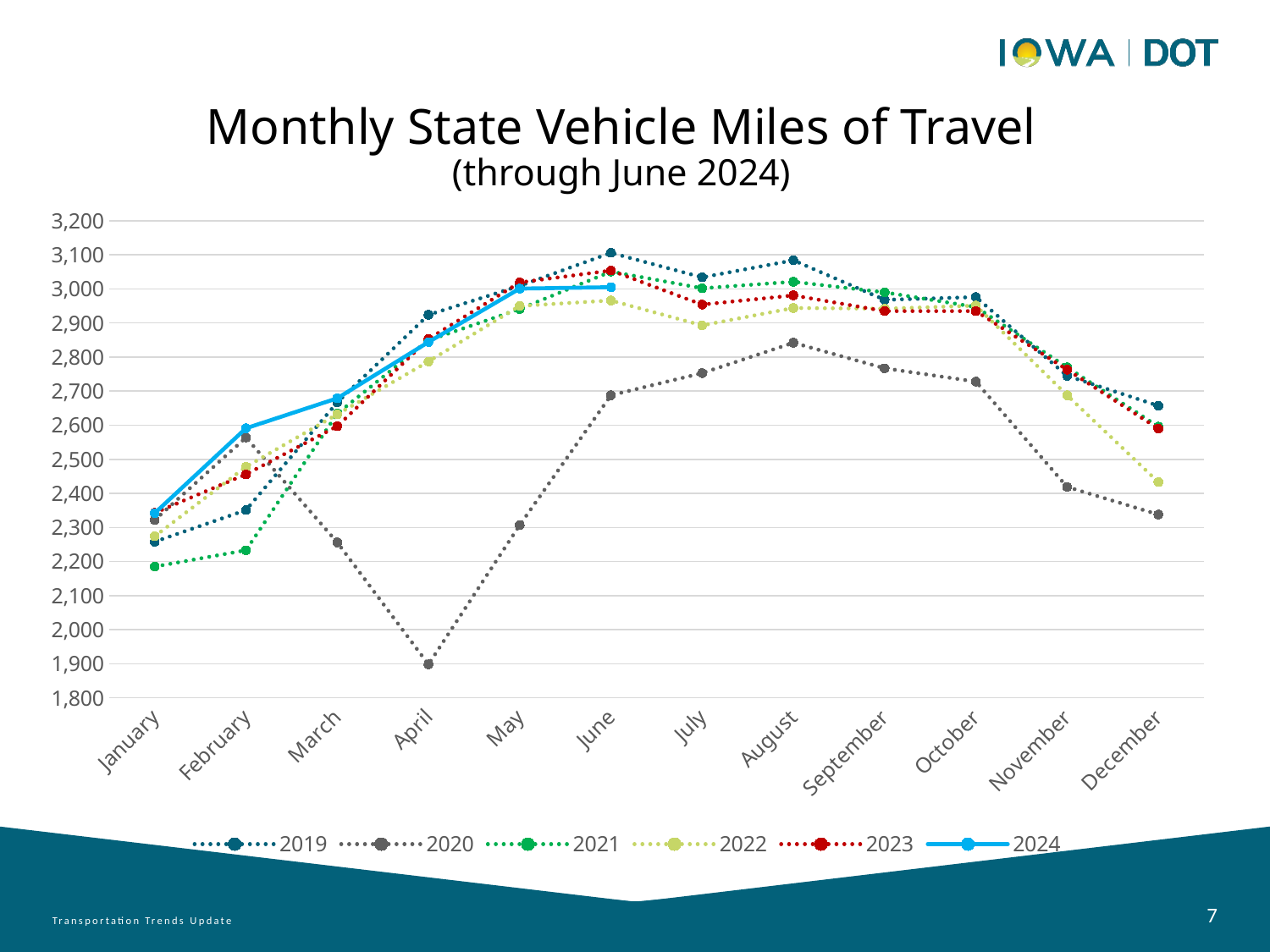
Is the value for 2020 in April greater or less than 2,000? less Which series is drawn as a solid line rather than a dotted line? 2024 In April, which is larger, the value for 2019 or the value for 2020? 2019 Is the value for 2020 in August greater or less than 2,800? greater How many months are shown along the x axis? 12 Which year has the lowest value in April? 2020 Does the 2020 line rise or fall from January to April? fall Which year has the highest value in June? 2019 What kind of chart is shown on the slide? line chart How many series does the legend list? 6 Is the value for 2019 in June greater or less than 3,000? greater Which year has the lowest value in December? 2020